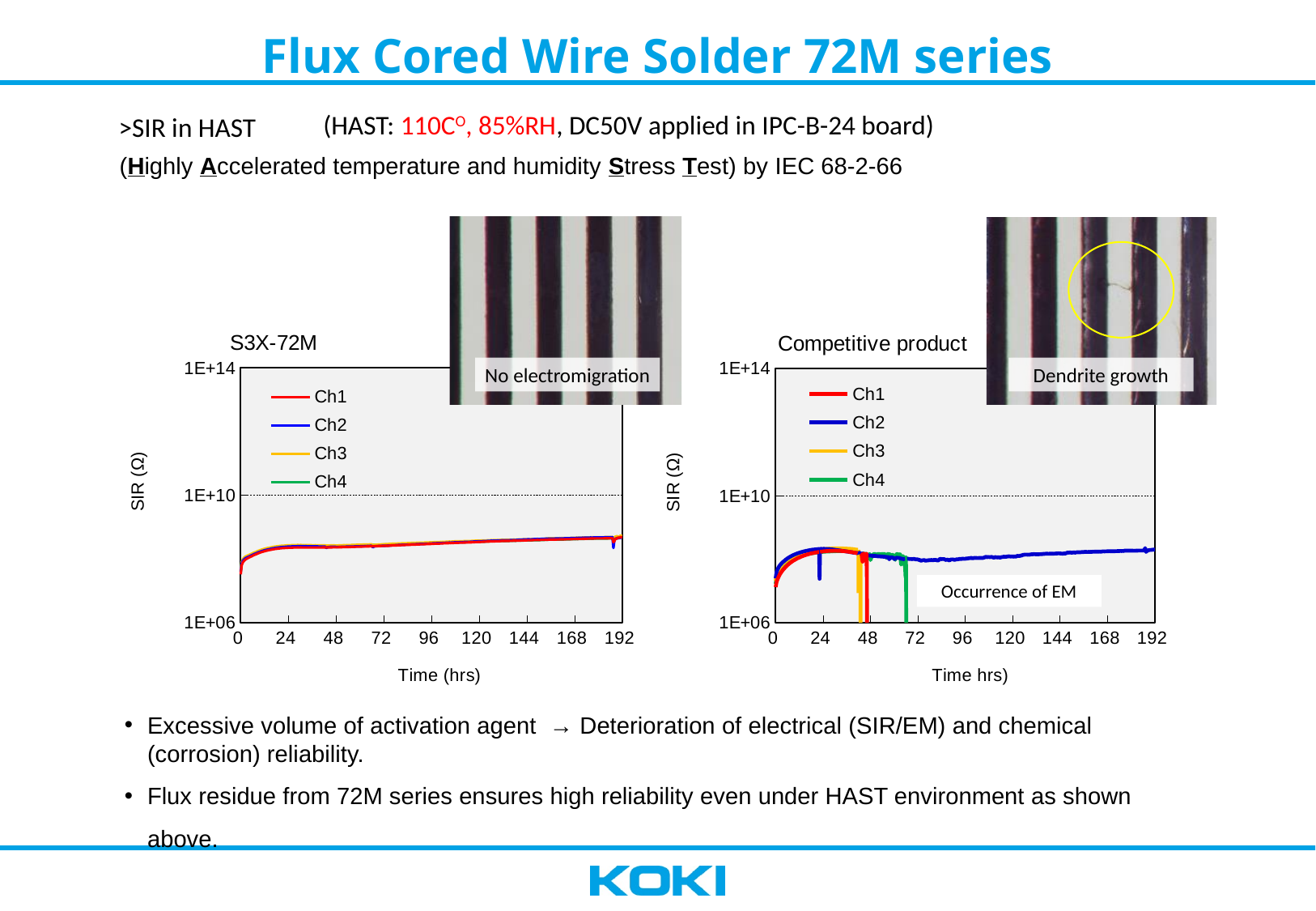
In the S3X-72M chart, is the value for Ch1 at 96 hrs greater or less than 1E+10? less How many series does the legend of the S3X-72M chart list? 4 In the Competitive product chart, does the Ch4 line rise or fall sharply around 72 hrs? fall In the S3X-72M chart, do the SIR values generally rise or fall from 24 hrs to 192 hrs? rise In the Competitive product chart, which channel has the highest SIR value at 192 hrs? Ch2 What kind of chart is the S3X-72M chart? line chart How many series does the legend of the Competitive product chart list? 4 What is the title of the chart on the right side of the slide? Competitive product How many tick labels are shown on the x axis of the S3X-72M chart? 9 What is the y-axis label of the S3X-72M chart? SIR (Ω) In the Competitive product chart, is the value for Ch2 at 24 hrs greater or less than 1E+06? greater In the Competitive product chart, is the value for Ch2 at 192 hrs greater or less than 1E+10? less